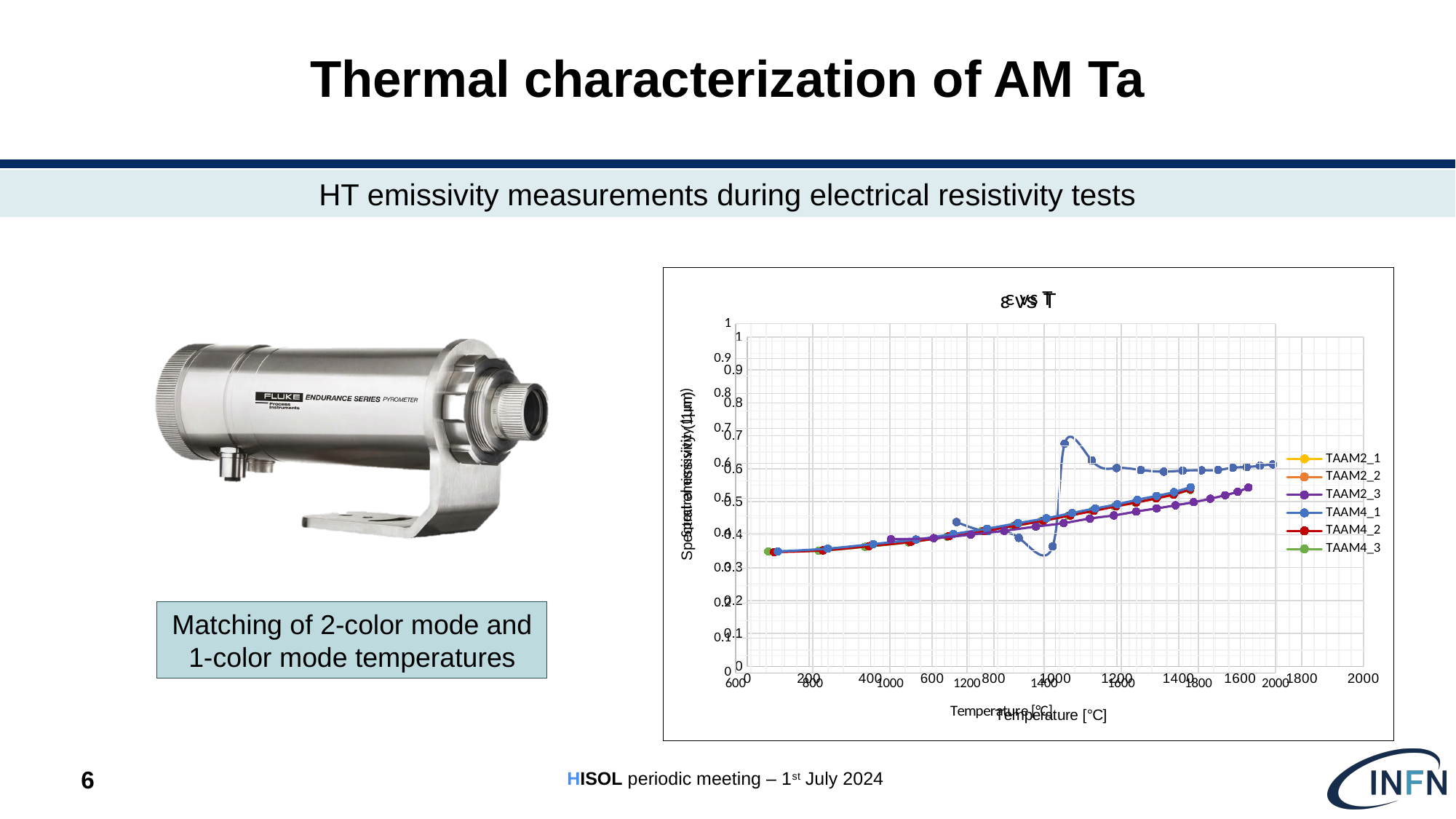
What is the label of the x axis of the chart? Temperature [°C] What is the title of the chart? ε vs T How many series does the chart legend list? 6 Is the peak value of the TAAM4_1 series greater or less than 0.8? less Do the emissivity values of the TAAM2_3 series generally rise or fall as temperature increases? rise What is the highest tick value shown on the y axis of the chart? 1 Are the lowest plotted emissivity values on the chart greater or less than 0.3? greater What kind of chart is shown on the slide? line chart Is the final value of the TAAM2_3 series greater or less than 0.5? greater